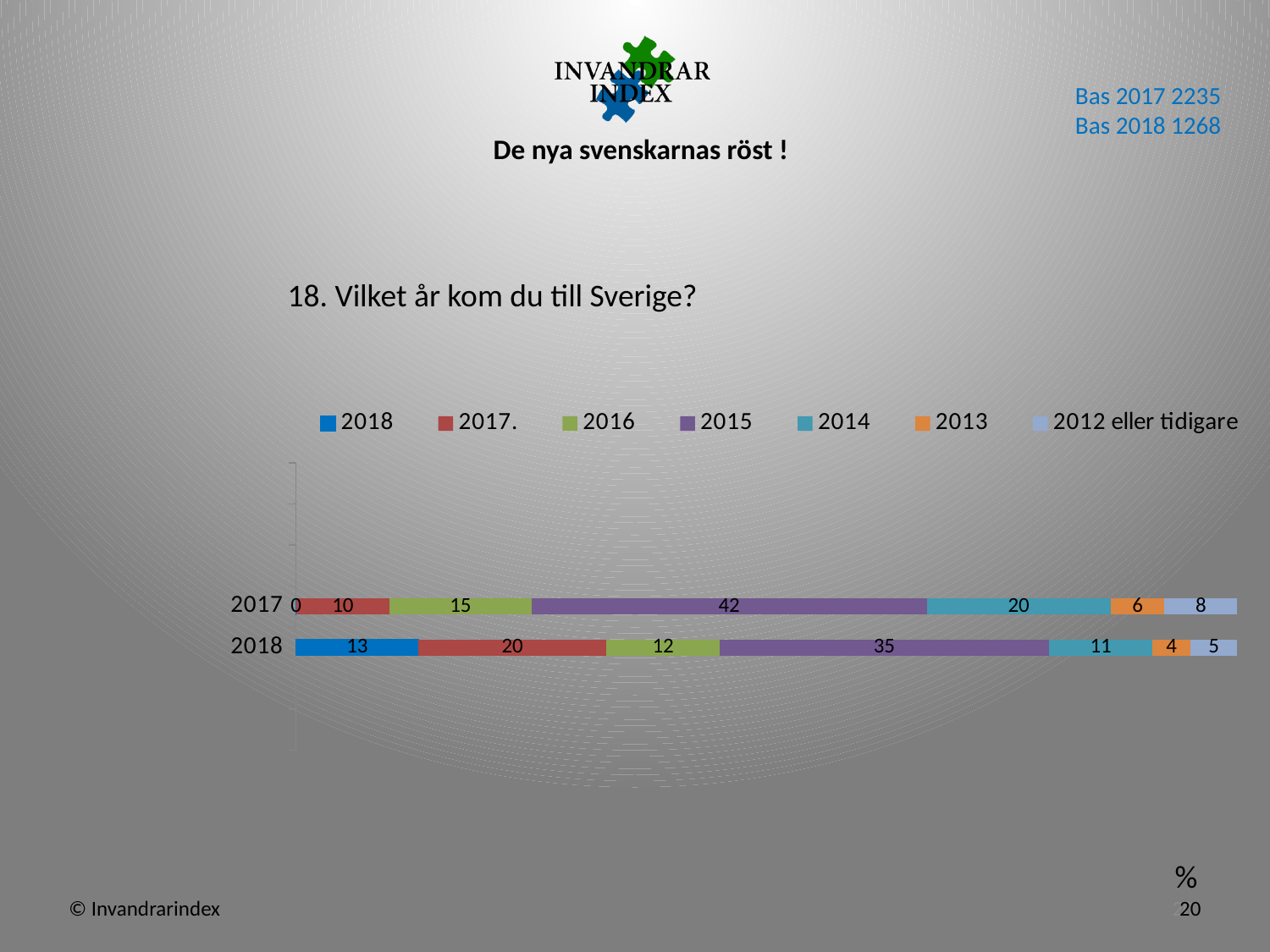
How many bars (survey years) are shown in the chart? 2 Which is larger: the 2017. segment in the 2017 bar or the 2017. segment in the 2018 bar? 2018 bar How many series does the legend list? 7 What is the value of the 2015 segment in the 2017 bar? 42 What is the total of the 2018 stacked bar? 100 What is the value of the 2015 segment in the 2018 bar? 35 What is the difference between the 2014 segment in the 2017 bar and the 2014 segment in the 2018 bar? 9 What kind of chart is shown on the slide? stacked bar chart Which segment is the smallest in the 2018 bar? 2013 What is the value of the 2018 segment in the 2018 bar? 13 Which segment is the largest in the 2017 bar? 2015 What is the value of the 2012 eller tidigare segment in the 2017 bar? 8